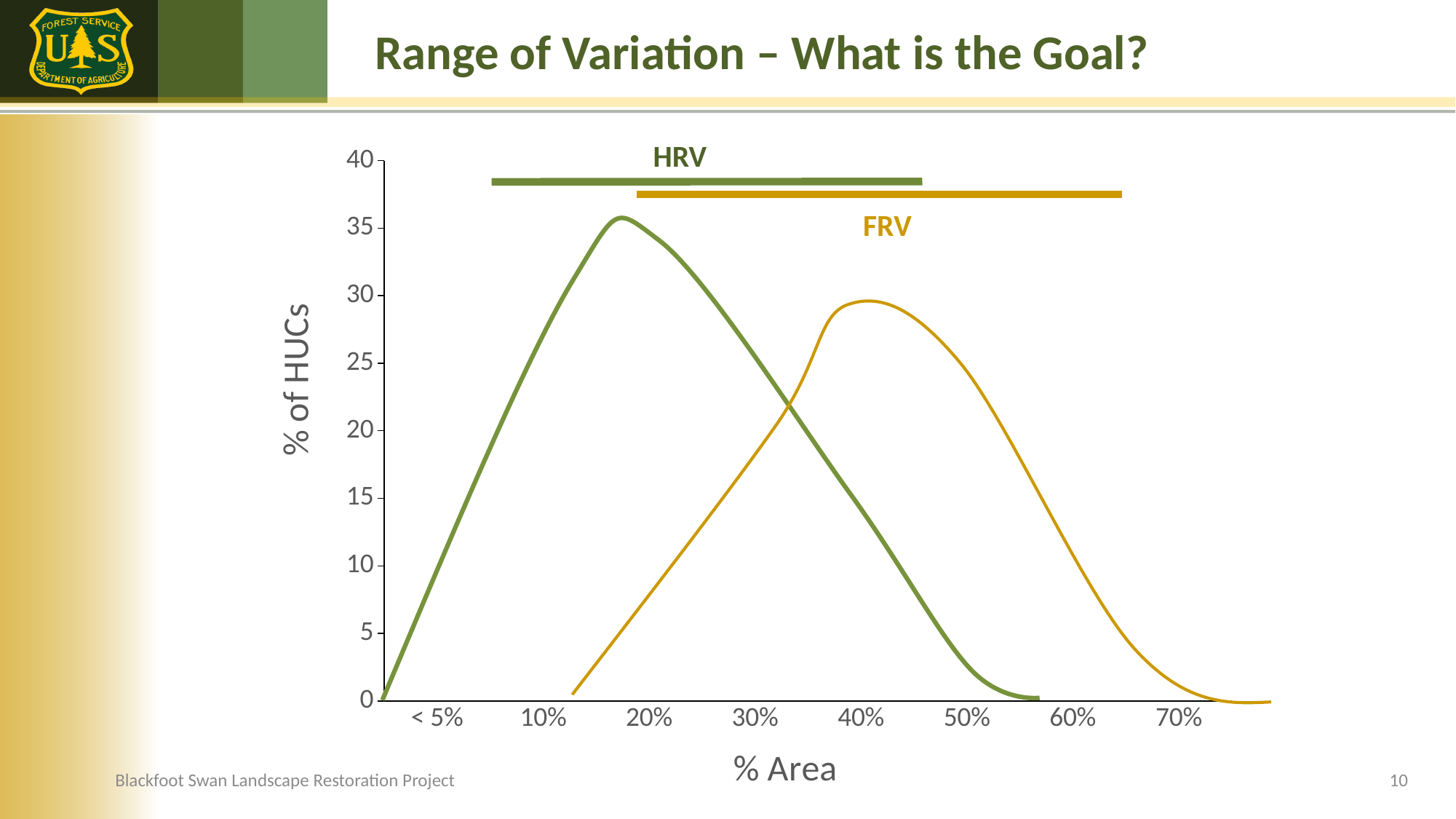
Is the peak value of the FRV curve greater or less than 25? greater Is the peak value of the HRV curve greater or less than 30? greater Is the value of the FRV curve at 50% Area greater or less than 20? greater What are the names of the two series plotted on the chart? HRV and FRV What kind of chart is shown on the slide? line chart Which series reaches the higher peak value, HRV or FRV? HRV Which series peaks at a larger % Area, HRV or FRV? FRV How many tick labels are shown on the x axis? 8 What is the label of the y axis? % of HUCs How many series (curves) are plotted on the chart? 2